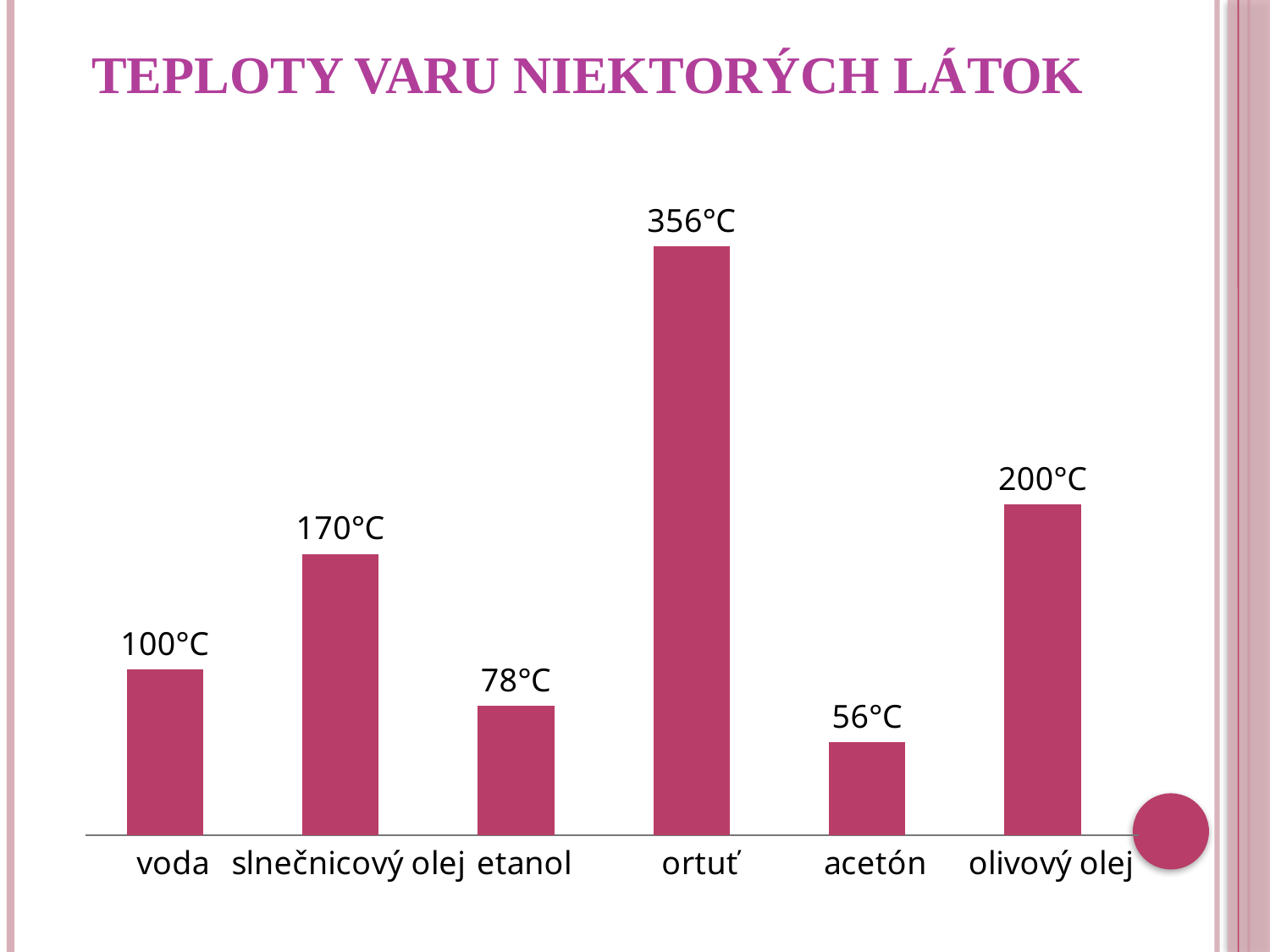
Which has a higher value, slnečnicový olej or etanol? slnečnicový olej Which substance has the lowest boiling point on the chart? acetón How many substances are shown on the chart? 6 What value is shown for olivový olej? 200°C What value is shown for acetón? 56°C What value is shown for ortuť? 356°C What is the difference between the values for olivový olej and slnečnicový olej? 30°C What kind of chart is shown on the slide? bar chart What is the difference between the values for voda and etanol? 22°C What is the title of the slide? TEPLOTY VARU NIEKTORÝCH LÁTOK Which substance has the highest boiling point on the chart? ortuť What is the boiling point shown for voda? 100°C